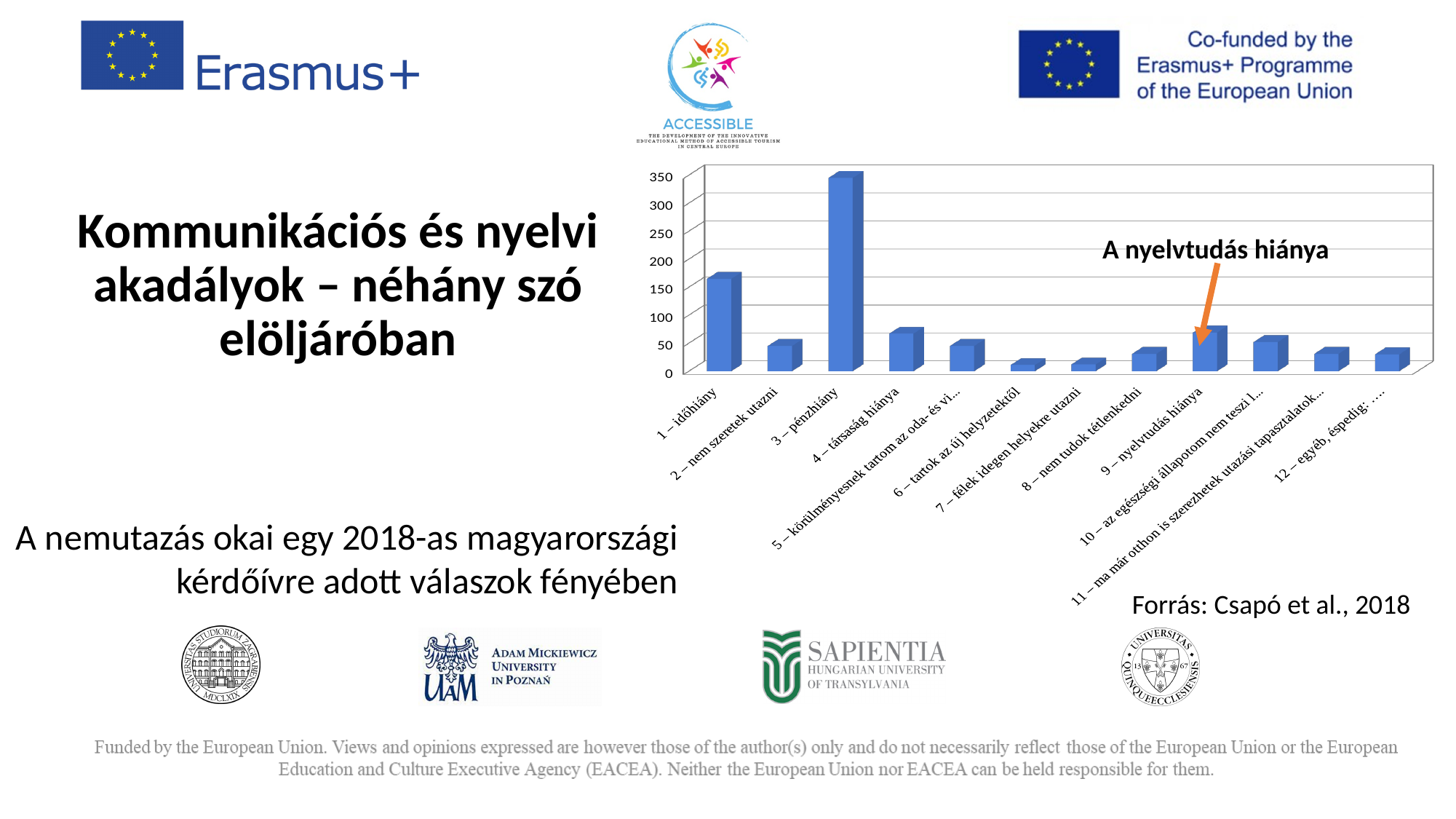
Is the value for "1 – időhiány" greater or less than 100? greater Which bar does the orange arrow labelled "A nyelvtudás hiánya" point to? 9 – nyelvtudás hiánya Which is larger, the value for "3 – pénzhiány" or for "1 – időhiány"? 3 – pénzhiány Is the value for "9 – nyelvtudás hiánya" greater or less than 50? greater What source is cited for the chart on the slide? Csapó et al., 2018 Which category has the highest value in the chart? 3 – pénzhiány What kind of chart is shown on the slide? bar chart Is the value for "9 – nyelvtudás hiánya" greater or less than 100? less How many categories (reasons) are plotted on the x axis of the chart? 12 Which is larger, the value for "1 – időhiány" or for "9 – nyelvtudás hiánya"? 1 – időhiány